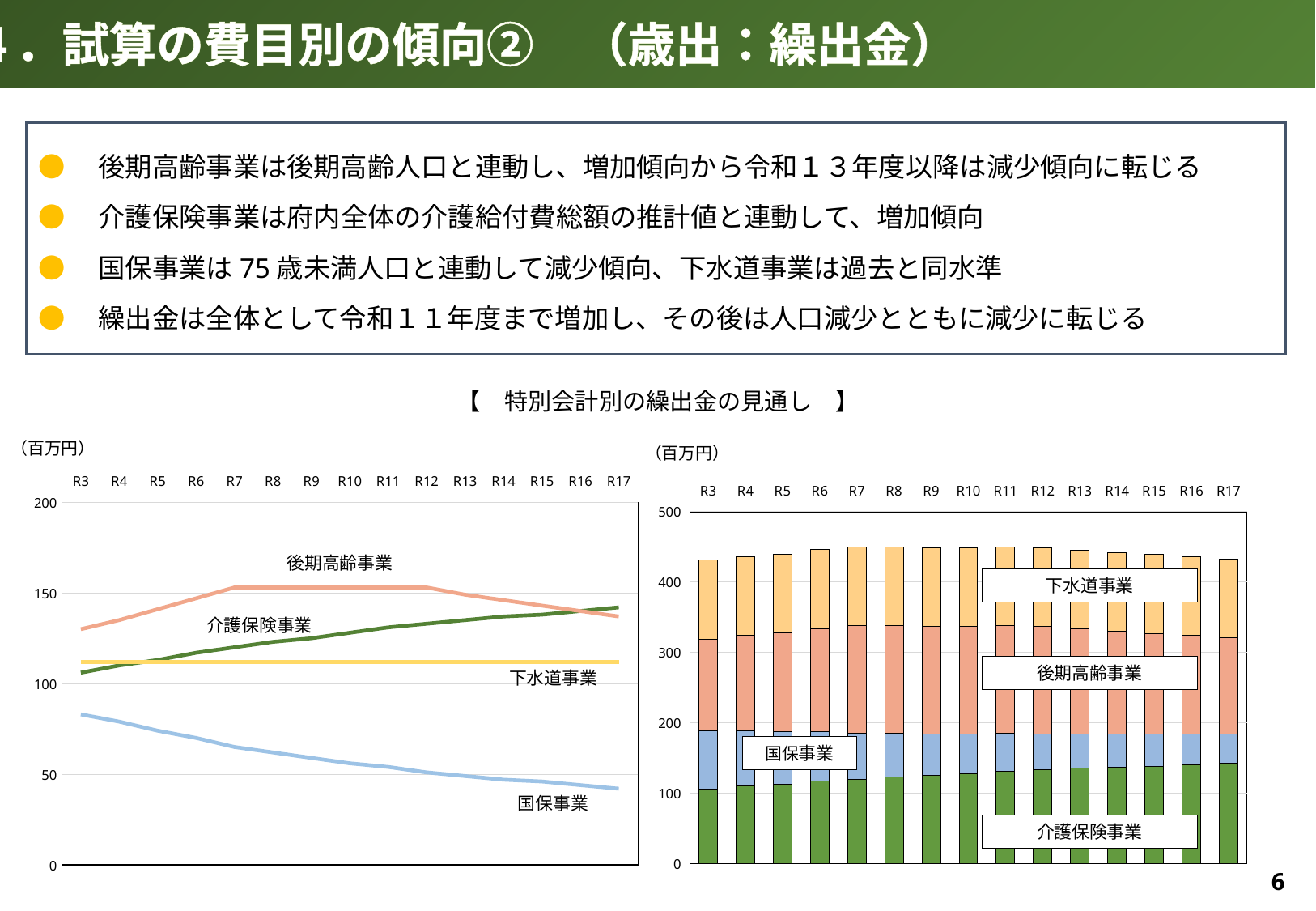
In the left chart, which series has the highest value at R10? 後期高齢事業 In the right chart, which series forms the bottom segment of each stacked bar? 介護保険事業 In the left chart, is the value for 後期高齢事業 at R3 greater or less than 150? less In the left chart, does the value for 介護保険事業 rise or fall from R3 to R17? rise In the left chart, is the value for 国保事業 at R3 greater or less than 100? less In the left chart, how many series (lines) are plotted? 4 In the right chart, is the total height of the stacked bar for R3 greater or less than 400? greater What kind of chart is the chart on the right of the slide? bar chart In the left chart, does the value for 国保事業 rise or fall from R3 to R17? fall In the left chart, how many fiscal years are plotted along the x axis? 15 In the left chart, which series has the lowest value at R3? 国保事業 What kind of chart is the chart on the left of the slide? line chart